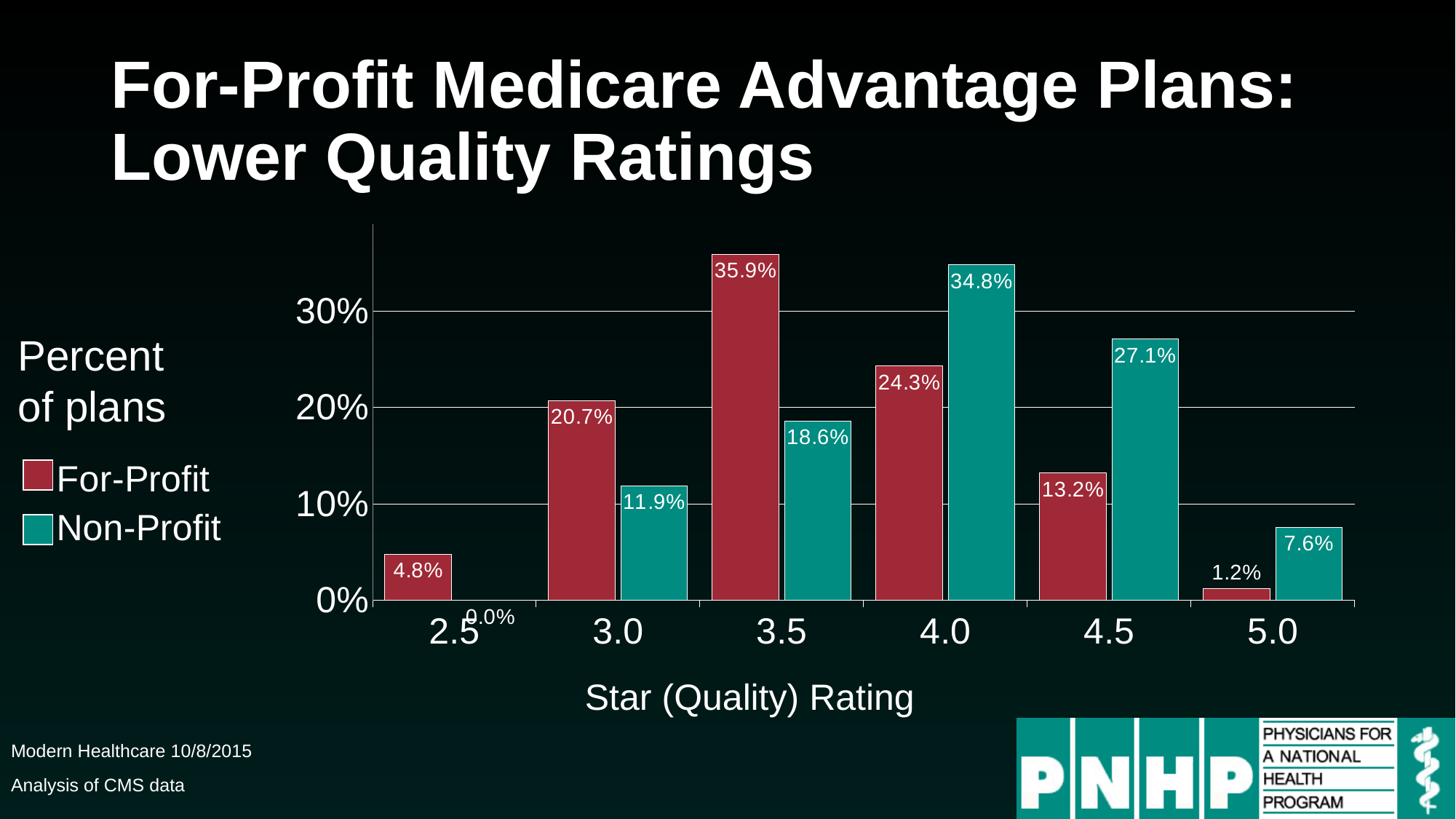
Which star rating has the lowest percent of Non-Profit plans? 2.5 How many series does the legend list? 2 What percent of Non-Profit plans have a 2.5 star rating? 0.0% Which star rating has the highest percent of For-Profit plans? 3.5 What percent of Non-Profit plans have a 4.0 star rating? 34.8% What percent of For-Profit plans have a 3.5 star rating? 35.9% What kind of chart is shown on the slide? Bar chart What is the label of the x axis? Star (Quality) Rating What percent of For-Profit plans have a 5.0 star rating? 1.2% How many star rating categories are shown on the x axis? 6 What is the difference between the For-Profit and Non-Profit percentages at the 4.5 star rating? 13.9% At the 3.0 star rating, which is larger: the For-Profit or the Non-Profit percentage? For-Profit